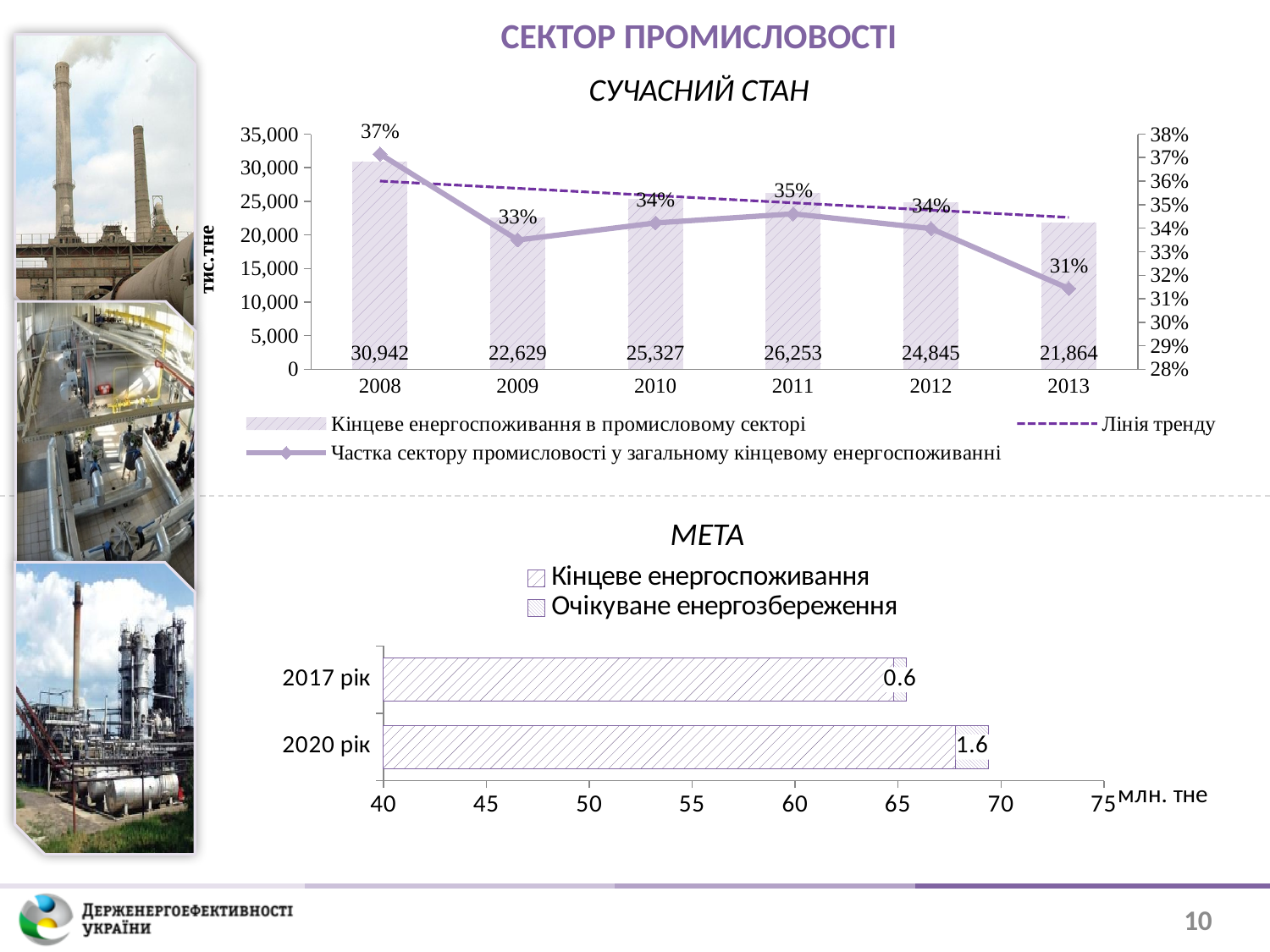
In the top chart (СУЧАСНИЙ СТАН), which year has the lowest final energy consumption in the industrial sector? 2013 In the bottom chart (МЕТА), what is the expected energy saving (Очікуване енергозбереження) for 2020 рік? 1.6 In the top chart (СУЧАСНИЙ СТАН), what is the difference between the final energy consumption in 2008 and in 2009? 8,313 In the top chart (СУЧАСНИЙ СТАН), which year has the larger final energy consumption, 2010 or 2011? 2011 In the bottom chart (МЕТА), what is the difference between the expected energy saving for 2020 рік and for 2017 рік? 1.0 In the top chart (СУЧАСНИЙ СТАН), how many years are shown on the x axis? 6 In the top chart (СУЧАСНИЙ СТАН), which year has the highest final energy consumption in the industrial sector? 2008 In the bottom chart (МЕТА), what unit is shown on the horizontal axis? млн. тне In the top chart (СУЧАСНИЙ СТАН), what is the share of the industrial sector in total final energy consumption in 2013? 31% In the top chart (СУЧАСНИЙ СТАН), does the share of the industrial sector rise or fall from 2011 to 2013? fall In the top chart (СУЧАСНИЙ СТАН), what is the final energy consumption in the industrial sector for 2008? 30,942 In the top chart (СУЧАСНИЙ СТАН), how many entries does the legend list? 3